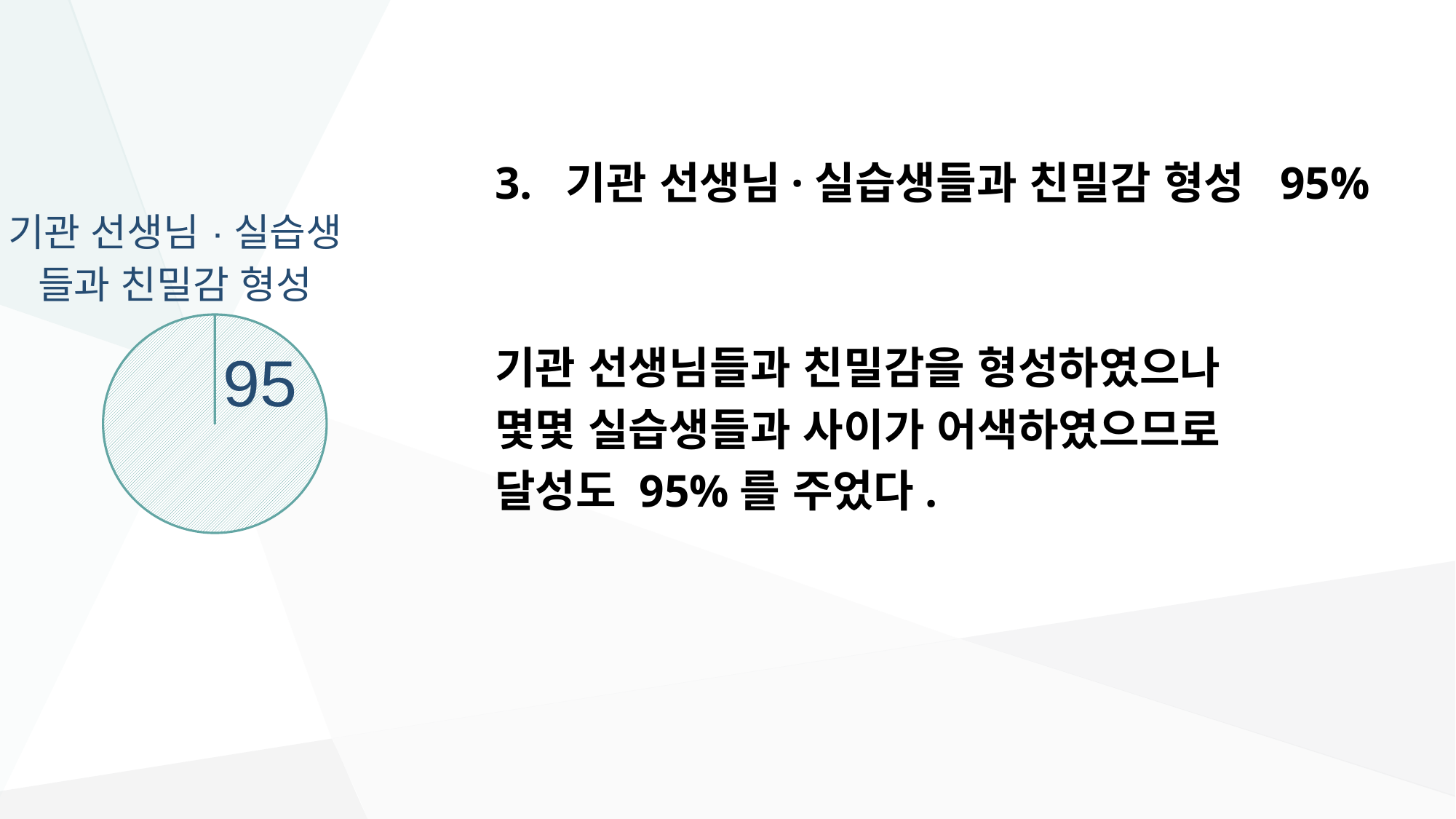
Does the labeled slice of the pie chart take up more or less than half of the pie? more What value is printed on the large slice of the pie chart? 95 What kind of chart is shown on the slide? pie chart How many data labels are printed on the pie chart? 1 Is the value shown on the pie chart's labeled slice greater or less than 50? greater What is the title of the pie chart? 기관 선생님 · 실습생들과 친밀감 형성